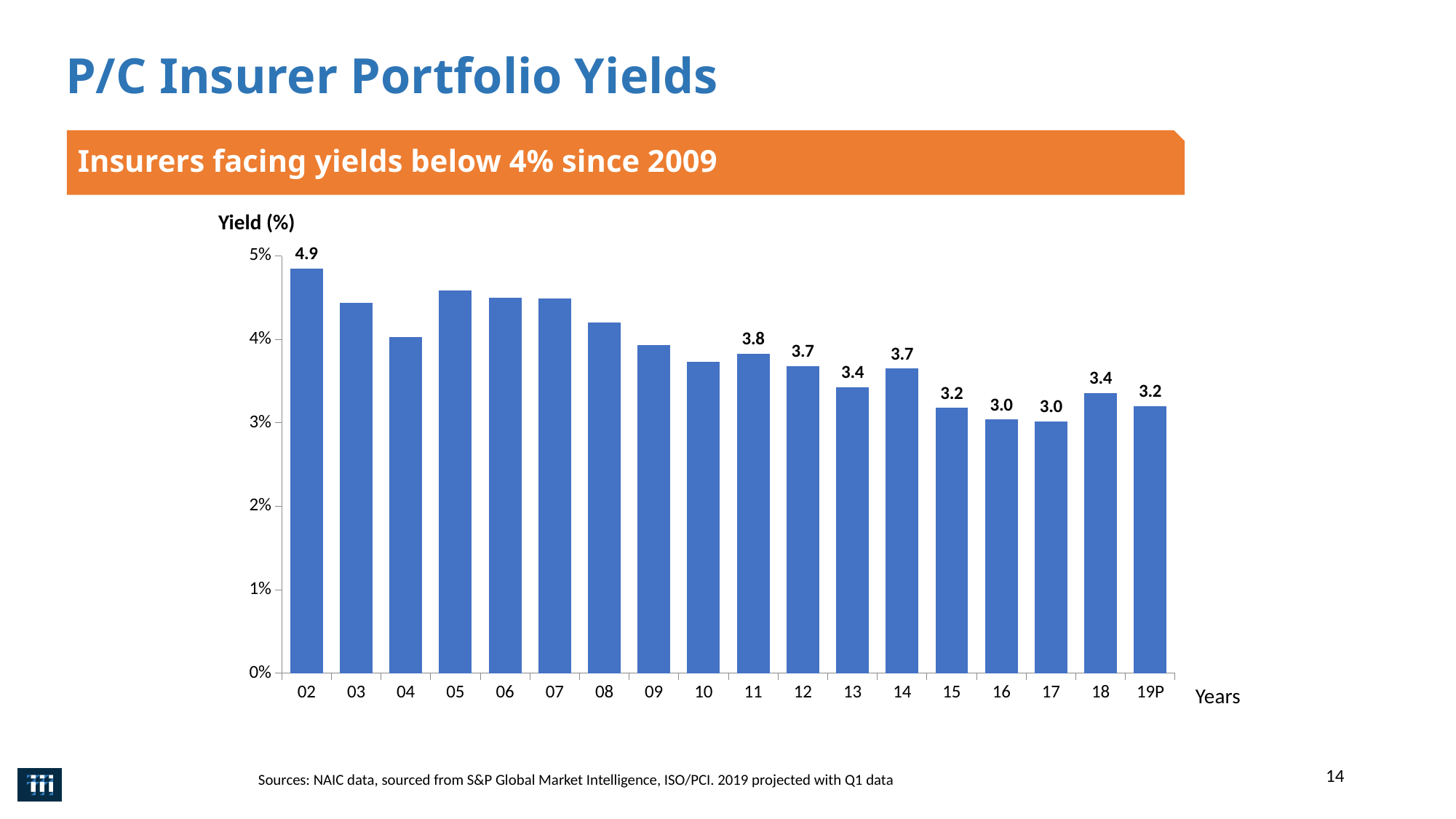
How many years are shown on the x axis? 18 Which year has the larger yield, 14 or 15? 14 What is the portfolio yield shown for 02? 4.9 What is the difference between the yield for 02 and the yield for 19P? 1.7 What kind of chart is used on this slide? bar chart Is the yield for 05 greater or less than 4%? greater What is the portfolio yield shown for 16? 3.0 Which year has the highest portfolio yield? 02 What is the portfolio yield shown for 19P? 3.2 Is the yield for 10 greater or less than 4%? less What is the difference between the yield for 11 and the yield for 13? 0.4 What is the portfolio yield shown for 11? 3.8